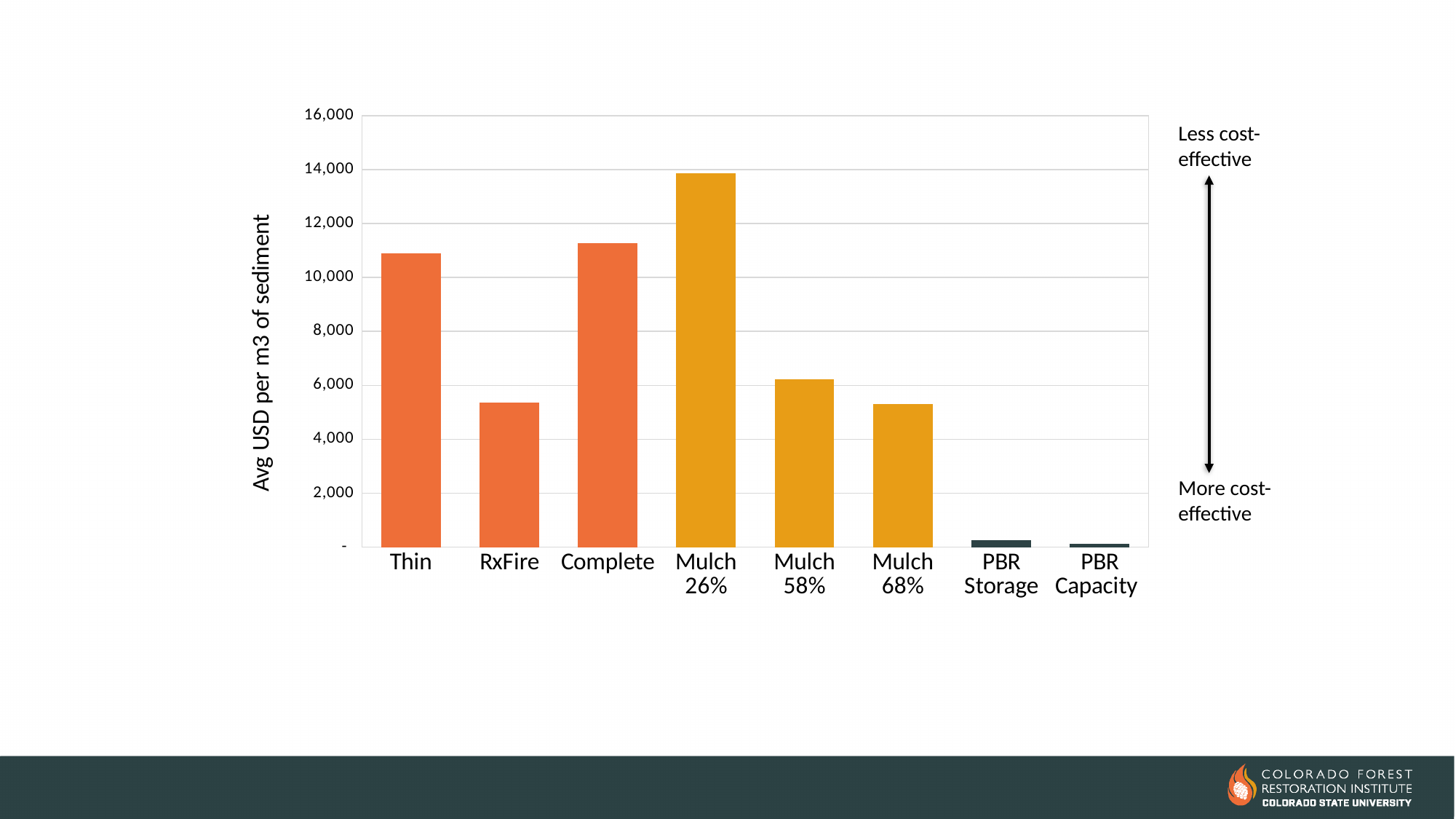
According to the annotation beside the chart, does a taller bar mean more or less cost-effective? Less cost-effective Which category has the highest average USD per m3 of sediment? Mulch 26% How many categories are shown on the x axis of the chart? 8 Is the value for Thin greater or less than 10,000? greater Is the value for Mulch 26% greater or less than 12,000? greater Is the value for PBR Storage greater or less than 2,000? less What kind of chart is shown on the slide? bar chart Which is larger, the value for Thin or the value for Mulch 26%? Mulch 26% What is the label on the vertical axis of the chart? Avg USD per m3 of sediment Which is larger, the value for Mulch 58% or the value for RxFire? Mulch 58%